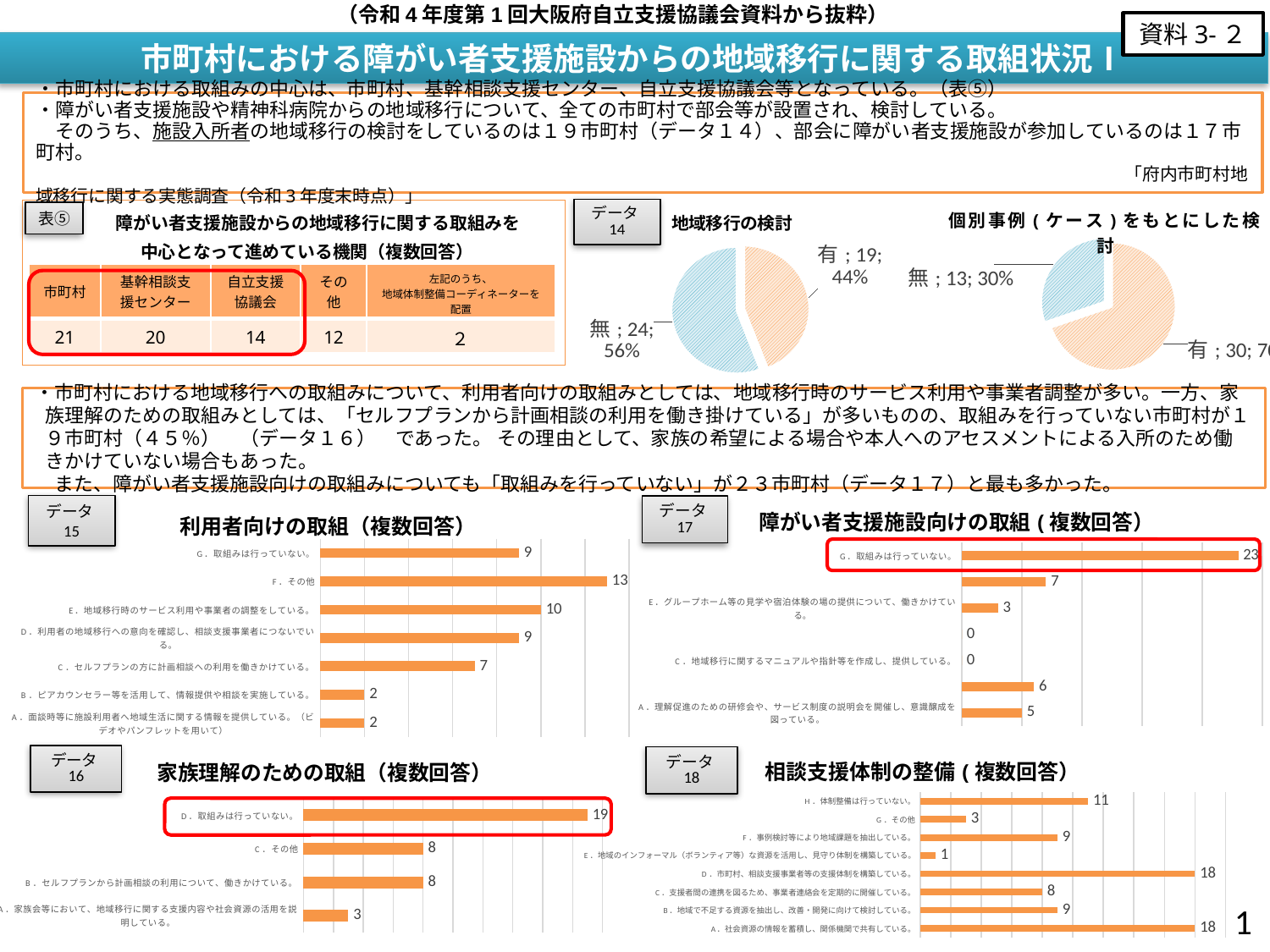
In the pie chart titled 個別事例（ケース）をもとにした検討, what is the value for 無? 13 In the pie chart titled 地域移行の検討, what is the value for 無? 24 In the bar chart titled 家族理解のための取組（複数回答）, which category has the lowest value? A．家族会等において、地域移行に関する支援内容や社会資源の活用を説明している。 What kind of chart is 相談支援体制の整備（複数回答）? bar chart In the bar chart titled 障がい者支援施設向けの取組（複数回答）, what is the difference between G．取組みは行っていない。 and A．理解促進のための研修会や、サービス制度の説明会を開催し、意識醸成を図っている。? 18 In the bar chart titled 相談支援体制の整備（複数回答）, which is larger: H．体制整備は行っていない。 or D．市町村、相談支援事業者等の支援体制を構築している。? D．市町村、相談支援事業者等の支援体制を構築している。 In the bar chart titled 利用者向けの取組（複数回答）, how many categories are shown? 7 In the bar chart titled 家族理解のための取組（複数回答）, what is the value for D．取組みは行っていない。? 19 In the bar chart titled 利用者向けの取組（複数回答）, what is the value for E．地域移行時のサービス利用や事業者の調整をしている。? 10 In the bar chart titled 障がい者支援施設向けの取組（複数回答）, what is the value for G．取組みは行っていない。? 23 In the pie chart titled 地域移行の検討, what percentage share does 有 have? 44% In the bar chart titled 利用者向けの取組（複数回答）, which category has the highest value? F．その他